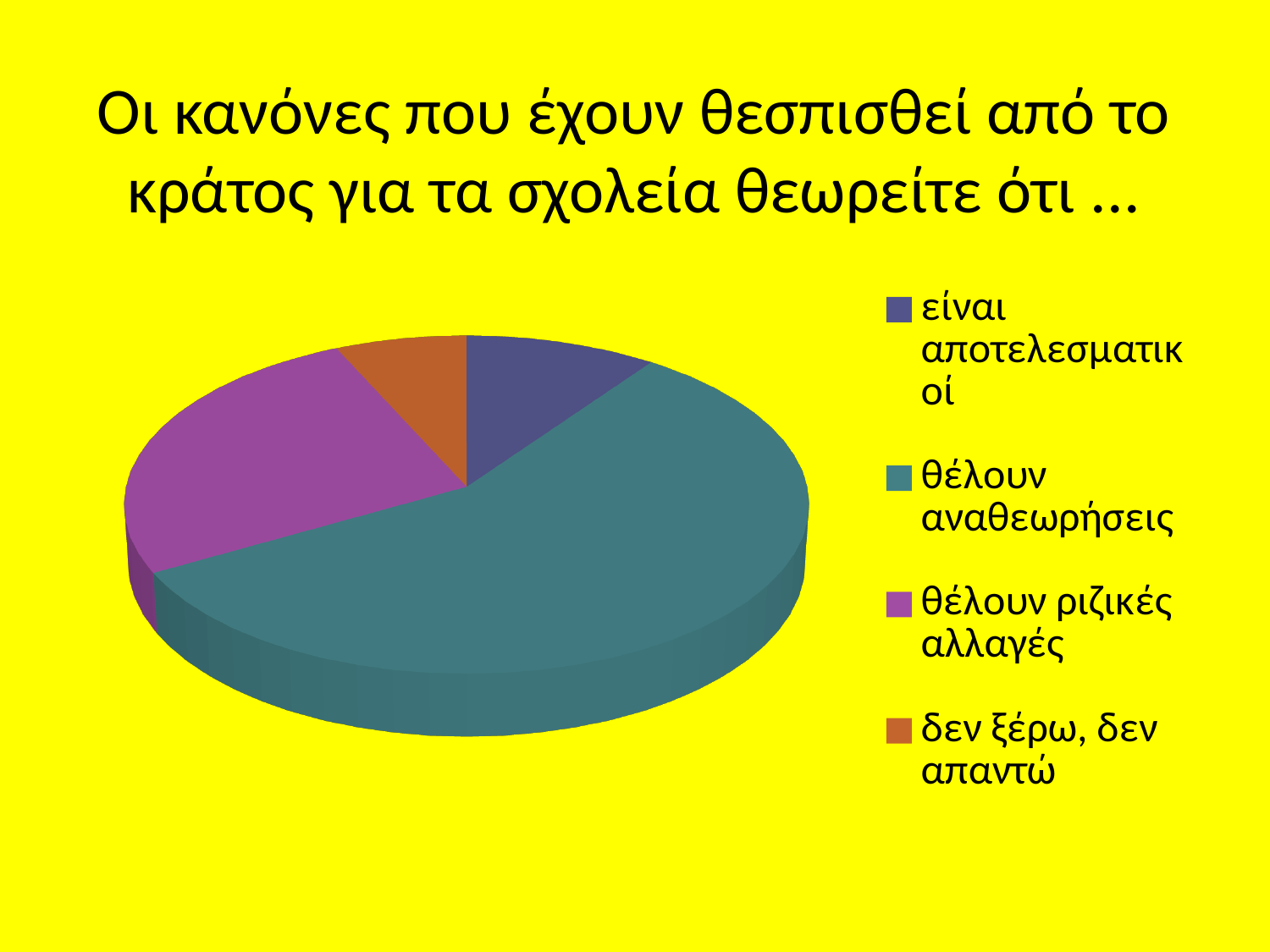
How many categories does the pie chart have? 4 What colour is the slice for "θέλουν ριζικές αλλαγές"? purple What kind of chart is shown on the slide? pie chart Which slice is larger: "είναι αποτελεσματικοί" or "δεν ξέρω, δεν απαντώ"? είναι αποτελεσματικοί Which category has the smallest slice of the pie? δεν ξέρω, δεν απαντώ Which slice is larger: "θέλουν ριζικές αλλαγές" or "είναι αποτελεσματικοί"? θέλουν ριζικές αλλαγές Which category has the largest slice of the pie? θέλουν αναθεωρήσεις What is the title of the slide containing the pie chart? Οι κανόνες που έχουν θεσπισθεί από το κράτος για τα σχολεία θεωρείτε ότι ... Which slice is larger: "θέλουν αναθεωρήσεις" or "θέλουν ριζικές αλλαγές"? θέλουν αναθεωρήσεις Does the slice for "θέλουν αναθεωρήσεις" take up more or less than half of the pie? more